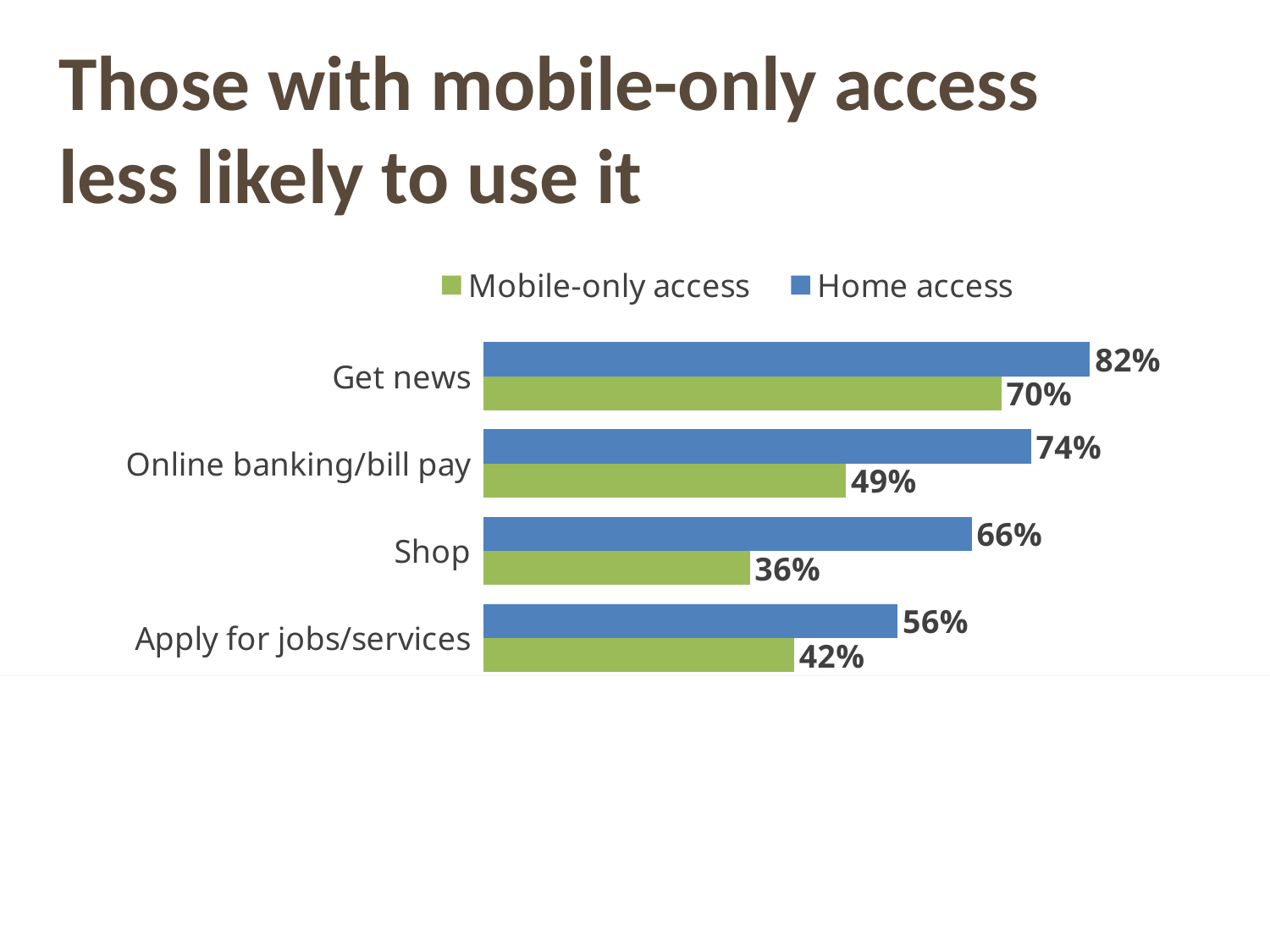
What is the Mobile-only access value for Shop? 36% How many categories are shown in the chart? 4 What is the difference between Home access and Mobile-only access for Get news? 12% What kind of chart is shown on the slide? Bar chart Which category has the highest Home access value? Get news What is the difference between Home access and Mobile-only access for Shop? 30% What is the Home access value for Get news? 82% What is the Home access value for Apply for jobs/services? 56% What is the Mobile-only access value for Online banking/bill pay? 49% How many series does the legend list? 2 Which category has the lowest Mobile-only access value? Shop Which is larger for Apply for jobs/services: Mobile-only access or Home access? Home access